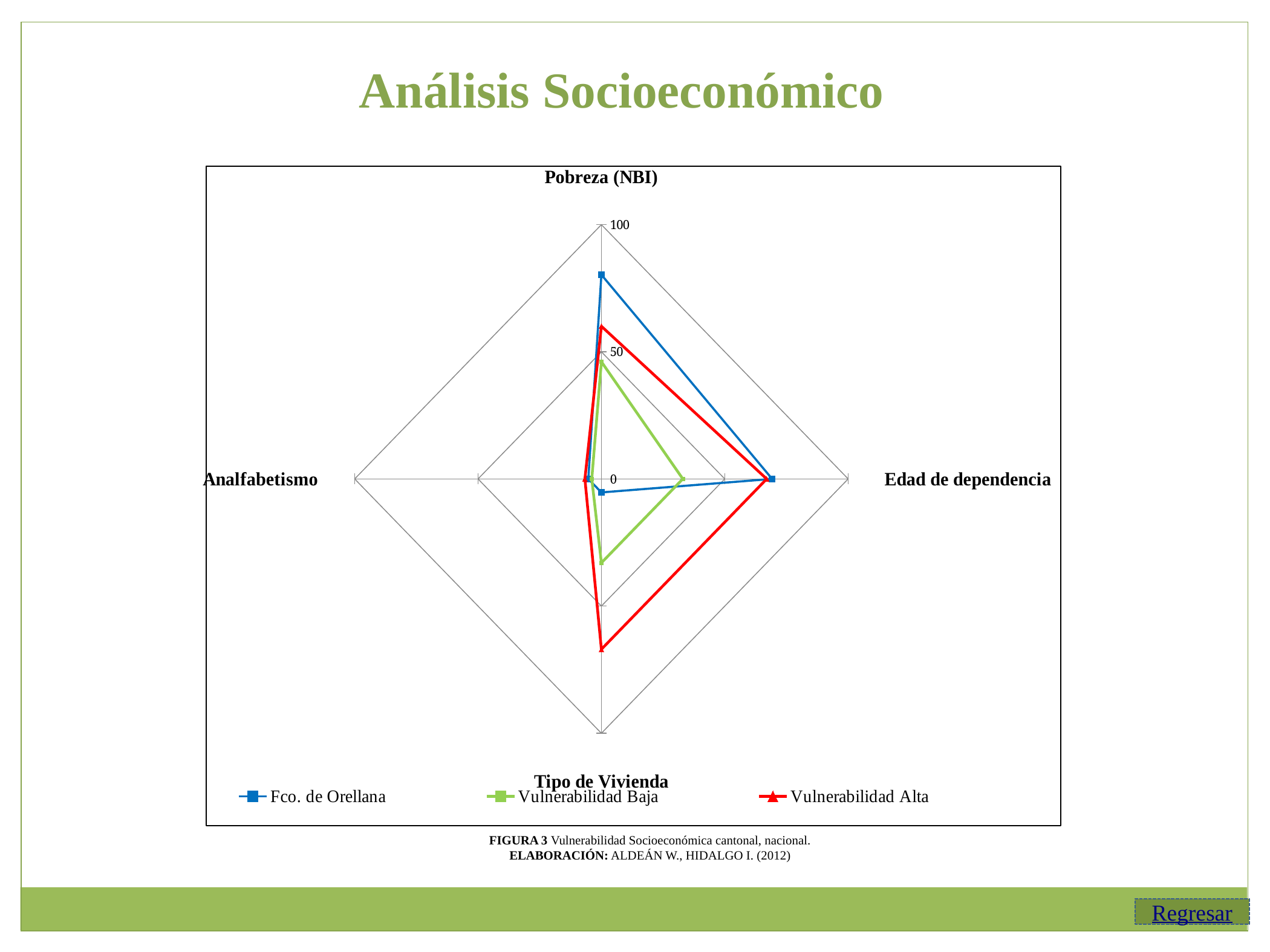
Is the Fco. de Orellana value for Pobreza (NBI) greater or less than 50? greater Is the Vulnerabilidad Baja value for Tipo de Vivienda greater or less than 50? less Which series is drawn in red in the chart? Vulnerabilidad Alta Is the Vulnerabilidad Alta value for Tipo de Vivienda greater or less than 50? greater How many series does the legend list? 3 Which series has the highest value on the Tipo de Vivienda axis? Vulnerabilidad Alta Which series has the lowest value on the Edad de dependencia axis? Vulnerabilidad Baja Which series has the lowest value on the Tipo de Vivienda axis? Fco. de Orellana Which series has the highest value on the Pobreza (NBI) axis? Fco. de Orellana How many axes (categories) does the radar chart have? 4 On the Pobreza (NBI) axis, which is larger: Fco. de Orellana or Vulnerabilidad Baja? Fco. de Orellana What kind of chart is shown on the slide? Radar chart